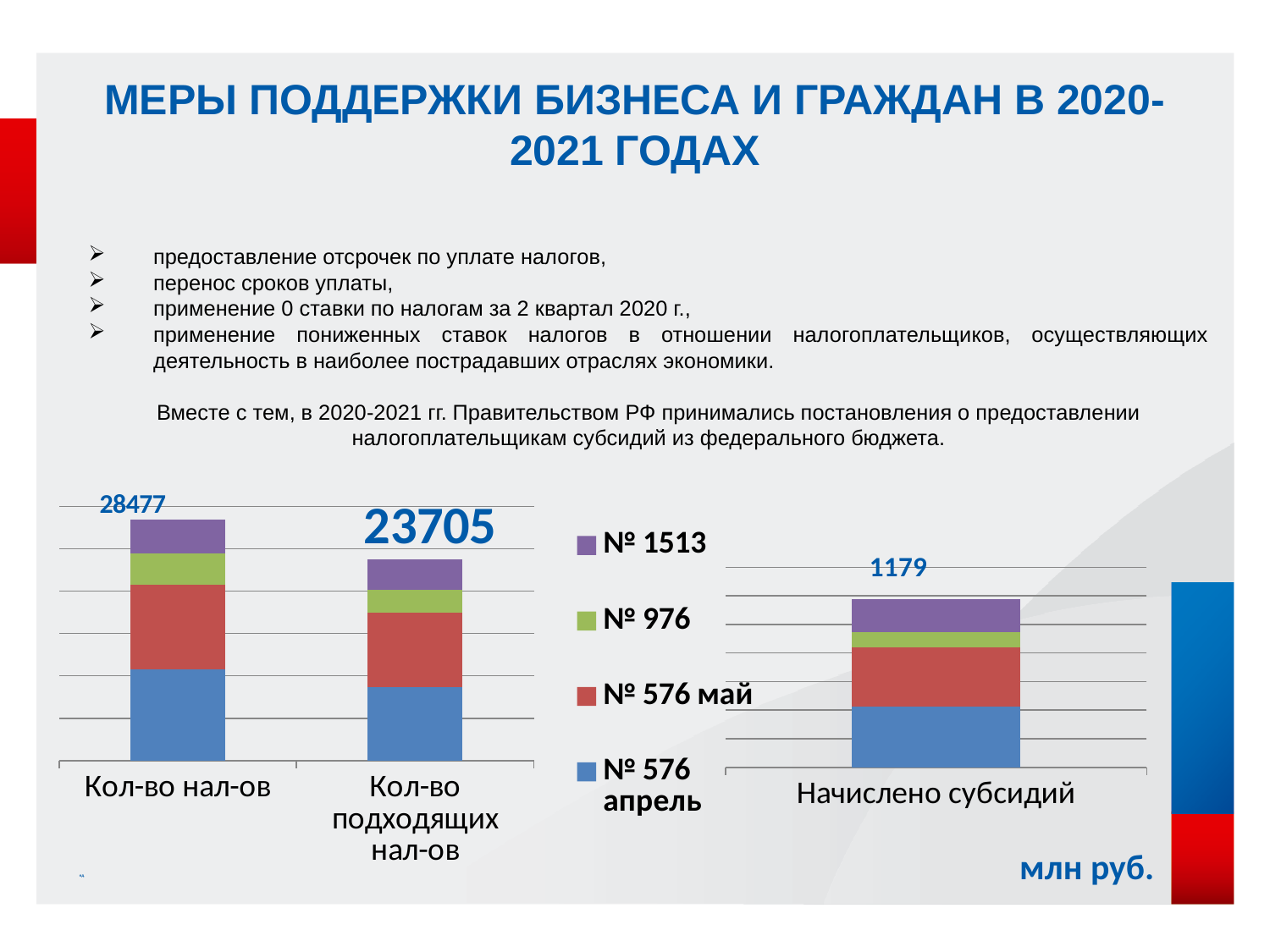
How many categories are shown on the left chart? 2 On the right chart, what is the total value shown for 'Начислено субсидий'? 1179 What unit is indicated for the right chart? млн руб. On the left chart, what is the total value shown for 'Кол-во нал-ов'? 28477 On the left chart, which category has the lowest total? Кол-во подходящих нал-ов On the left chart, what is the total value shown for 'Кол-во подходящих нал-ов'? 23705 How many series does the legend list? 4 Which legend entry is shown in purple? № 1513 What kind of chart is the left chart? stacked bar chart On the left chart, what is the difference between the totals for 'Кол-во нал-ов' and 'Кол-во подходящих нал-ов'? 4772 On the left chart, which series forms the bottom segment of each bar? № 576 апрель On the left chart, which category has the higher total, 'Кол-во нал-ов' or 'Кол-во подходящих нал-ов'? Кол-во нал-ов